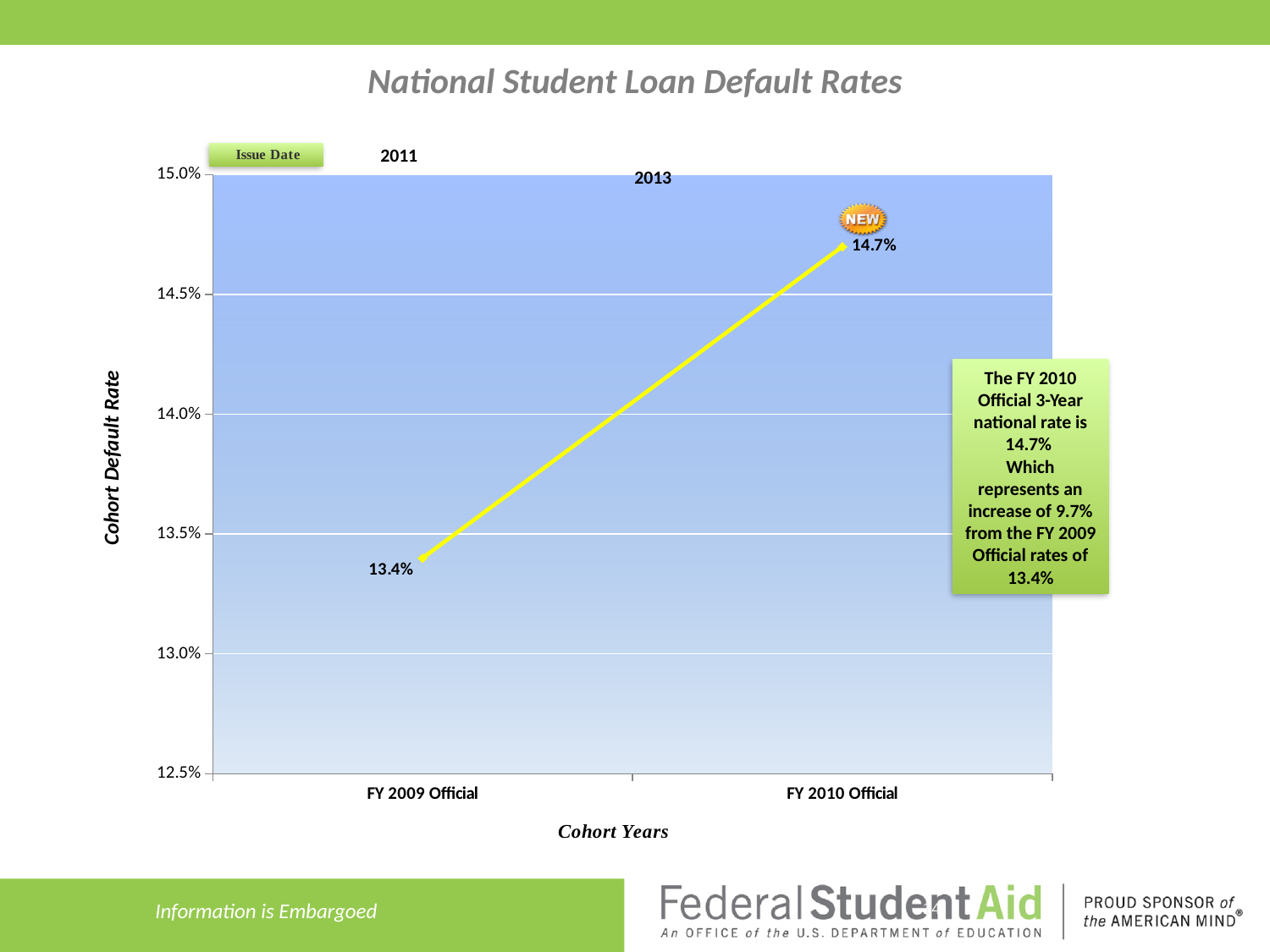
By how many percentage points does the FY 2010 Official rate exceed the FY 2009 Official rate? 1.3 Does the default rate rise or fall from FY 2009 Official to FY 2010 Official? rise What kind of chart is shown on the slide? line chart Which cohort year has the lower default rate? FY 2009 Official What is the cohort default rate for FY 2009 Official? 13.4% Which cohort year has the higher default rate? FY 2010 Official Is the default rate for FY 2010 Official larger or smaller than the rate for FY 2009 Official? larger Is the value for FY 2009 Official greater or less than 13.5%? less Is the value for FY 2010 Official greater or less than 14.5%? greater What is the title of the chart? National Student Loan Default Rates What is the cohort default rate for FY 2010 Official? 14.7% How many cohort years are plotted on the chart? 2